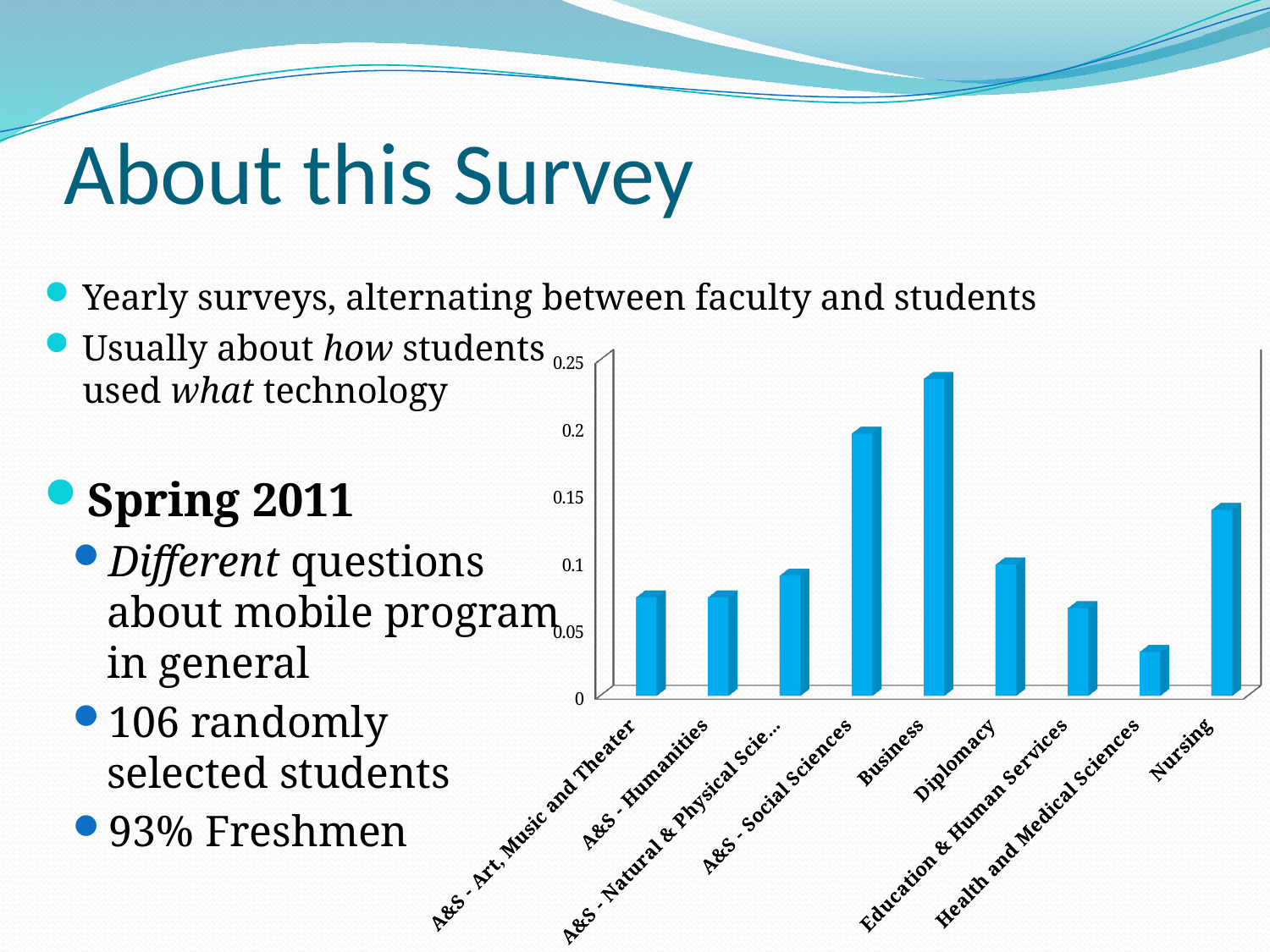
How many categories are plotted on the chart? 9 Is the value for A&S - Art, Music and Theater greater or less than 0.1? less Is the value for Business greater or less than 0.2? greater Which is larger, the value for A&S - Social Sciences or the value for Diplomacy? A&S - Social Sciences Which category has the highest bar on the chart? Business Which is larger, the value for Business or the value for Nursing? Business Is the value for Health and Medical Sciences greater or less than 0.05? less Which is larger, the value for Nursing or the value for Health and Medical Sciences? Nursing What kind of chart is shown on the slide? bar chart What is the highest value shown on the chart's vertical axis? 0.25 Which category has the lowest bar on the chart? Health and Medical Sciences